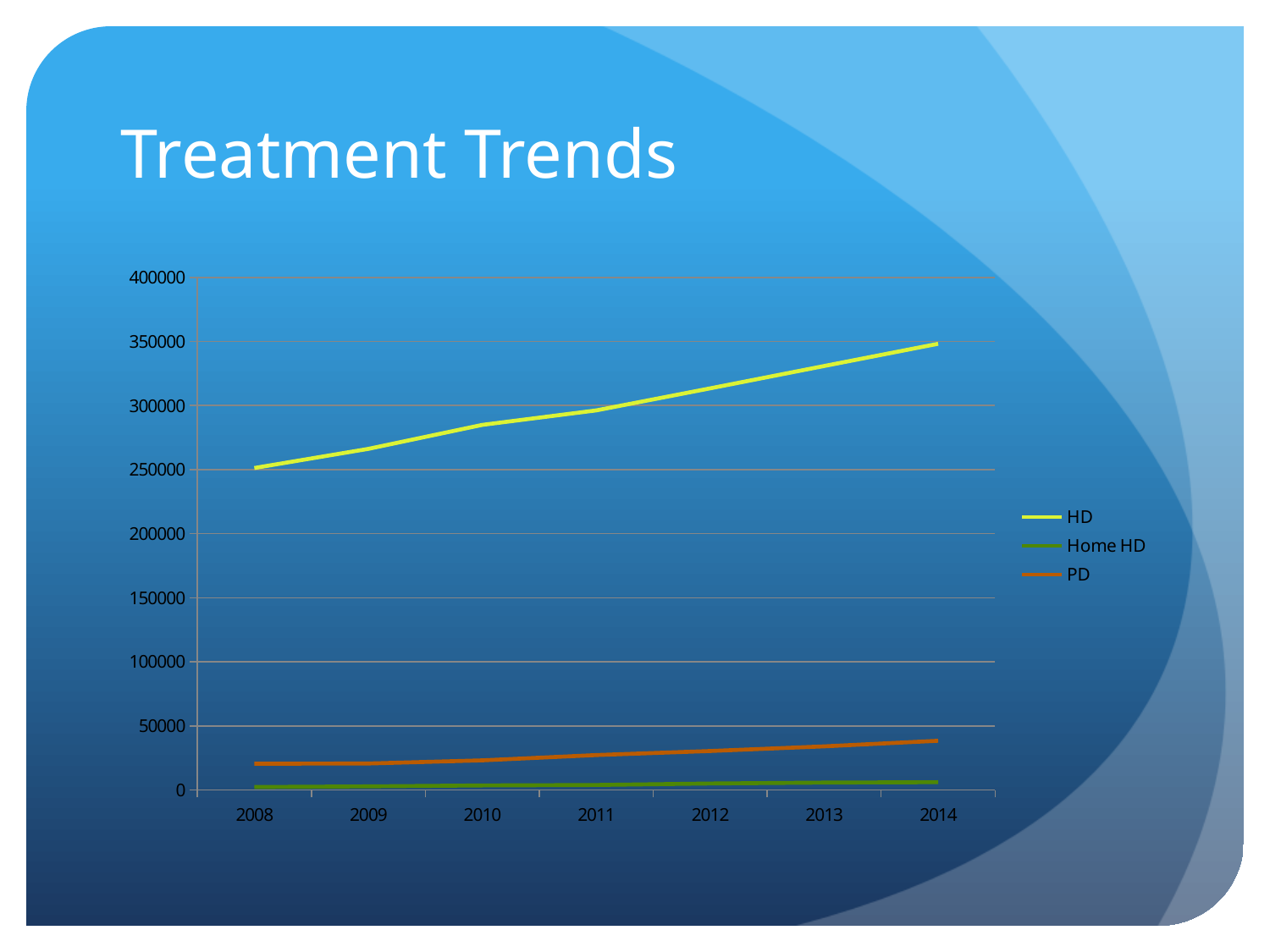
How many years are shown on the x axis? 7 Which is larger in 2012, the value for PD or the value for Home HD? PD Which series has the highest values across all years? HD Which series has the lowest values across all years? Home HD Is the value for PD in 2014 greater or less than 50000? less What is the title of the slide containing the chart? Treatment Trends Does the PD line rise or fall from 2008 to 2014? rise What kind of chart is shown on the slide? line chart Is the value for HD in 2008 greater or less than 200000? greater Is the value for HD in 2014 greater or less than 300000? greater How many series does the legend list? 3 Does the HD line rise or fall from 2008 to 2014? rise